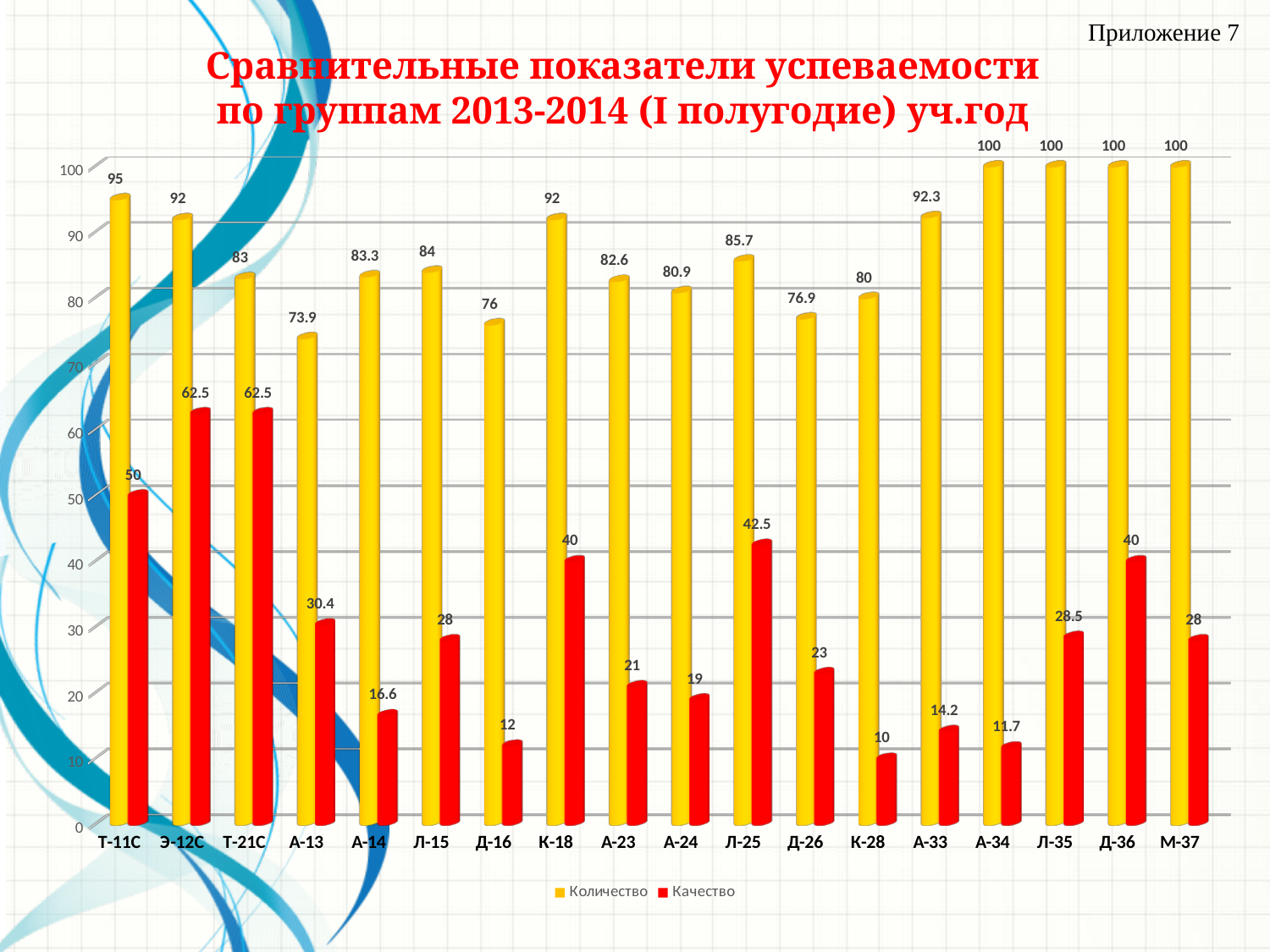
Which group has the lowest Качество value? К-28 What is the Качество value for group Л-35? 28.5 What is the Количество value for group Л-25? 85.7 What is the difference between the Количество and Качество values for group Т-11С? 45 How many groups are shown on the x axis? 18 What are the two series named in the legend? Количество and Качество What kind of chart is shown on the slide? bar chart How many series does the legend list? 2 What is the Качество value for group А-14? 16.6 Which group has the lowest Количество value? А-13 What is the difference between the Качество values of Э-12С and А-13? 32.1 Which group has the larger Качество value, Л-15 or Д-26? Л-15